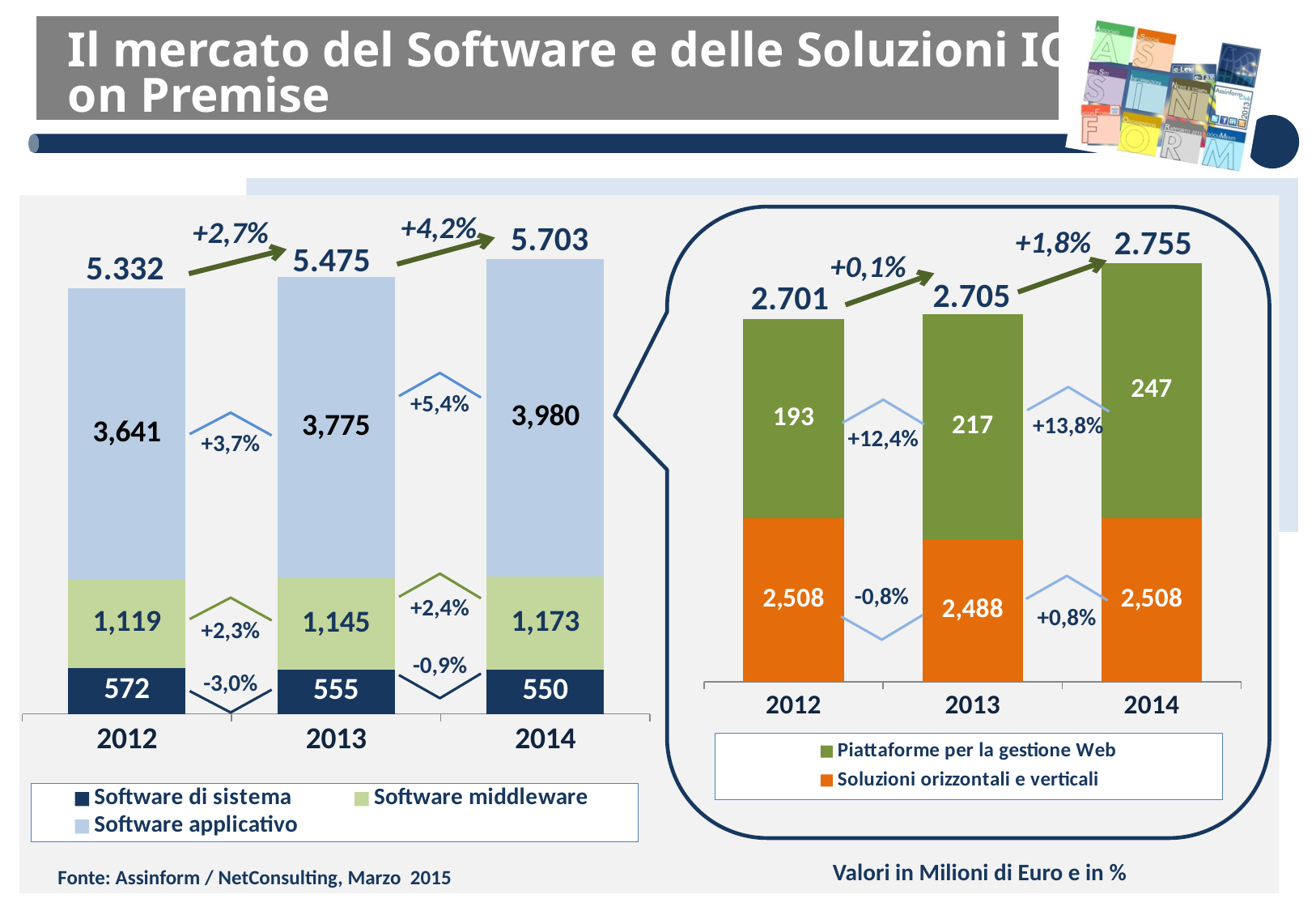
In the left chart, which year has the lowest value for Software di sistema? 2014 In the right chart, is the value for Soluzioni orizzontali e verticali larger in 2012 or in 2013? 2012 In the left chart, what is the difference between Software middleware in 2014 and in 2012? 54 In the left chart, what percentage change is shown for Software applicativo between 2013 and 2014? +5,4% In the left chart, how many series does the legend list? 3 In the right chart, what is the value for Piattaforme per la gestione Web in 2013? 217 What kind of chart is the right chart? Stacked bar chart In the left chart, what is the total shown above the 2013 stacked bar? 5.475 In the left chart, what is the value for Software applicativo in 2014? 3,980 In the right chart, which year has the highest value for Piattaforme per la gestione Web? 2014 In the right chart, what is the total shown above the 2014 stacked bar? 2.755 In the left chart, what is the value for Software di sistema in 2012? 572